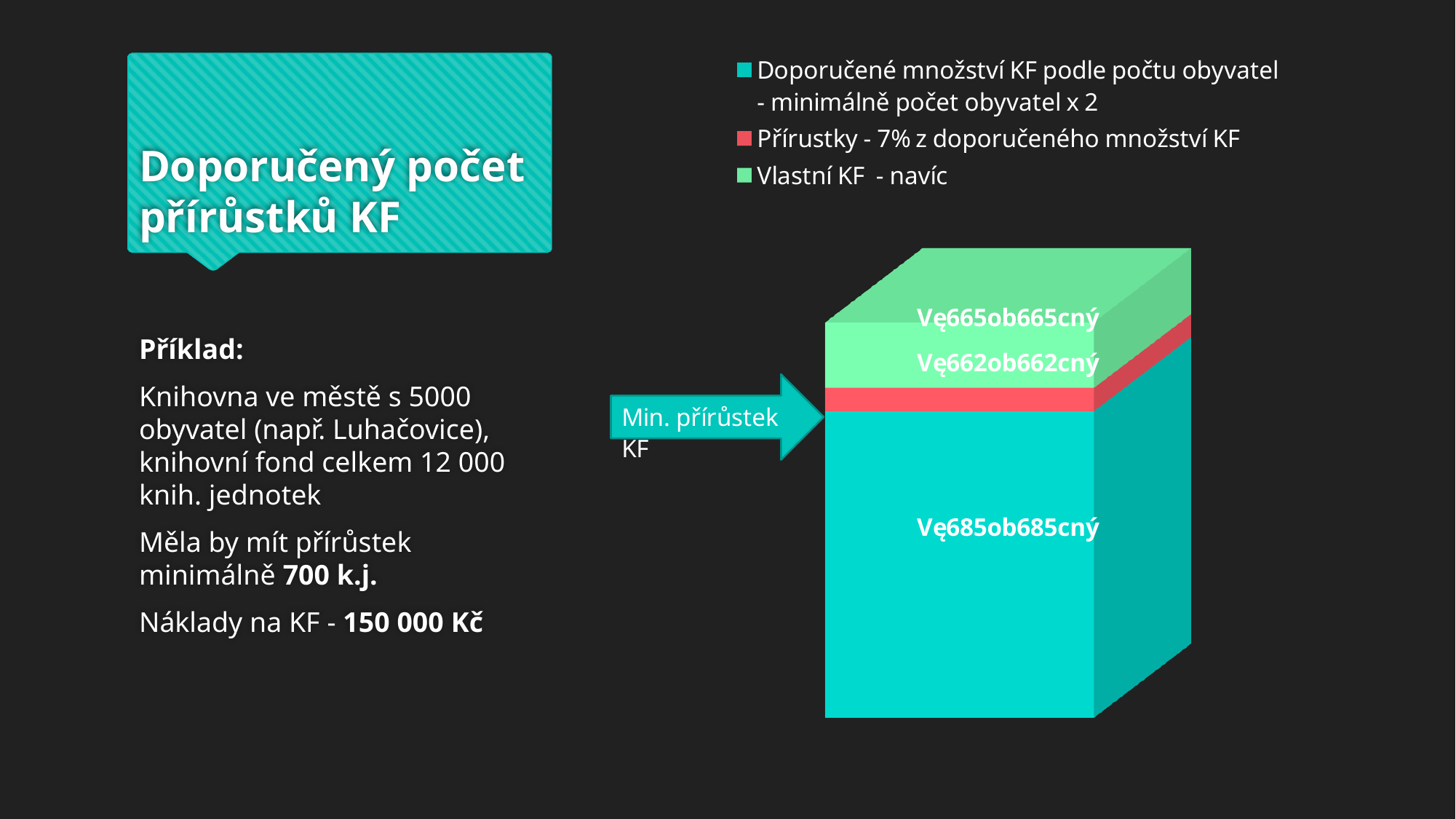
Which series is shown in light green in the chart? Vlastní KF - navíc How many stacked bars are plotted in the chart? 1 Which series occupies the largest segment of the stacked bar? Doporučené množství KF podle počtu obyvatel - minimálně počet obyvatel x 2 Which segment is larger in the stacked bar: 'Vlastní KF - navíc' or 'Přírustky - 7% z doporučeného množství KF'? Vlastní KF - navíc Which segment is larger in the stacked bar: 'Doporučené množství KF podle počtu obyvatel' or 'Vlastní KF - navíc'? Doporučené množství KF podle počtu obyvatel How many series does the chart legend list? 3 Which series occupies the smallest segment of the stacked bar? Přírustky - 7% z doporučeného množství KF What kind of chart is shown on the slide? Stacked bar chart What colour represents the series 'Přírustky - 7% z doporučeného množství KF' in the chart? Red